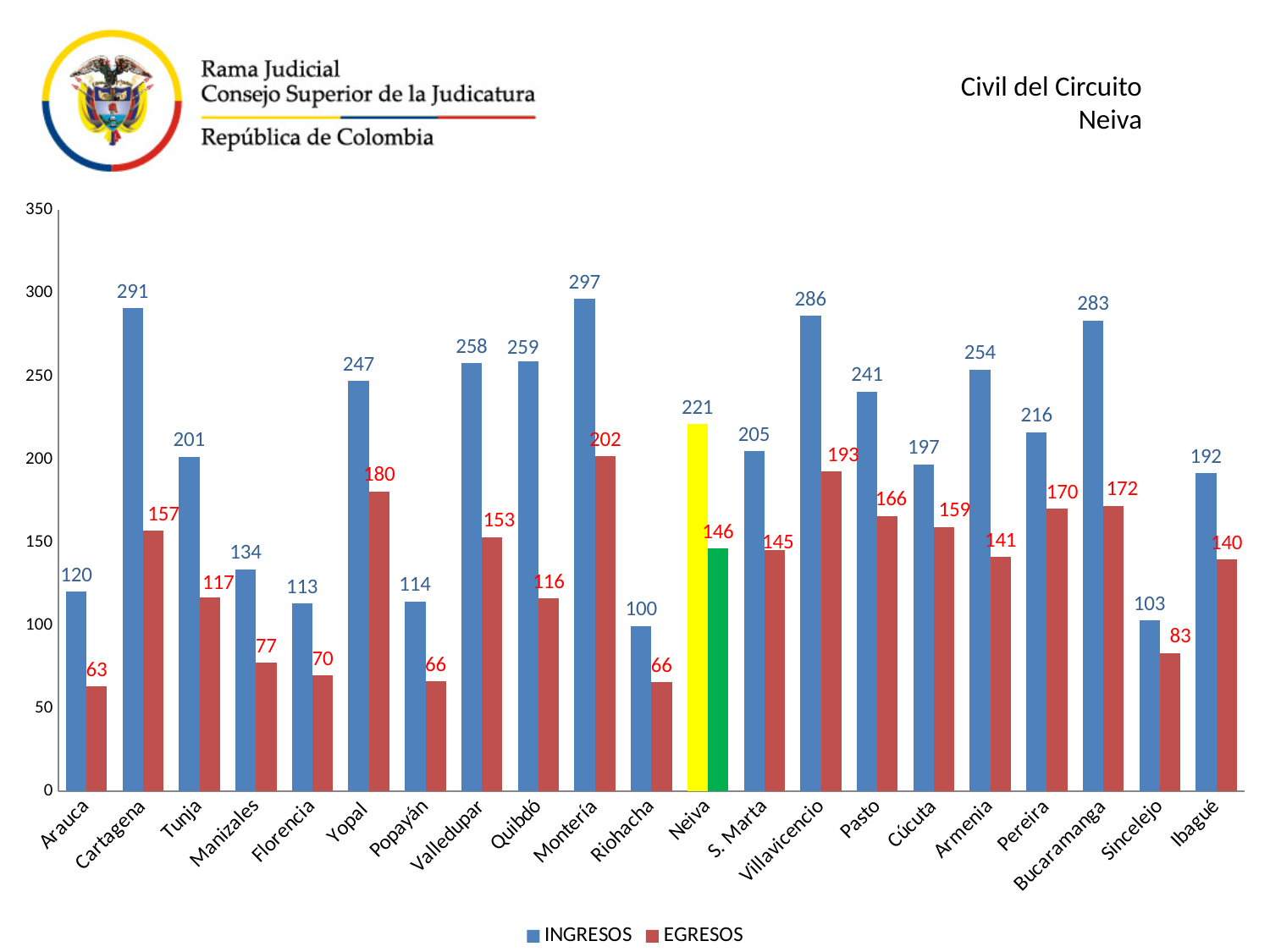
What is the difference between INGRESOS and EGRESOS for Neiva? 75 How many series does the legend list? 2 Which city has the lowest INGRESOS value? Riohacha Which city's bars are highlighted in yellow and green? Neiva How many cities are shown on the x axis? 21 What is the EGRESOS value for Villavicencio? 193 Is the EGRESOS value for Yopal greater or less than 150? greater Which is larger, the INGRESOS value for Cartagena or the INGRESOS value for Bucaramanga? Cartagena What kind of chart is shown on the slide? Bar chart Which city has the lowest EGRESOS value? Arauca Which city has the highest INGRESOS value? Montería What is the INGRESOS value for Neiva? 221